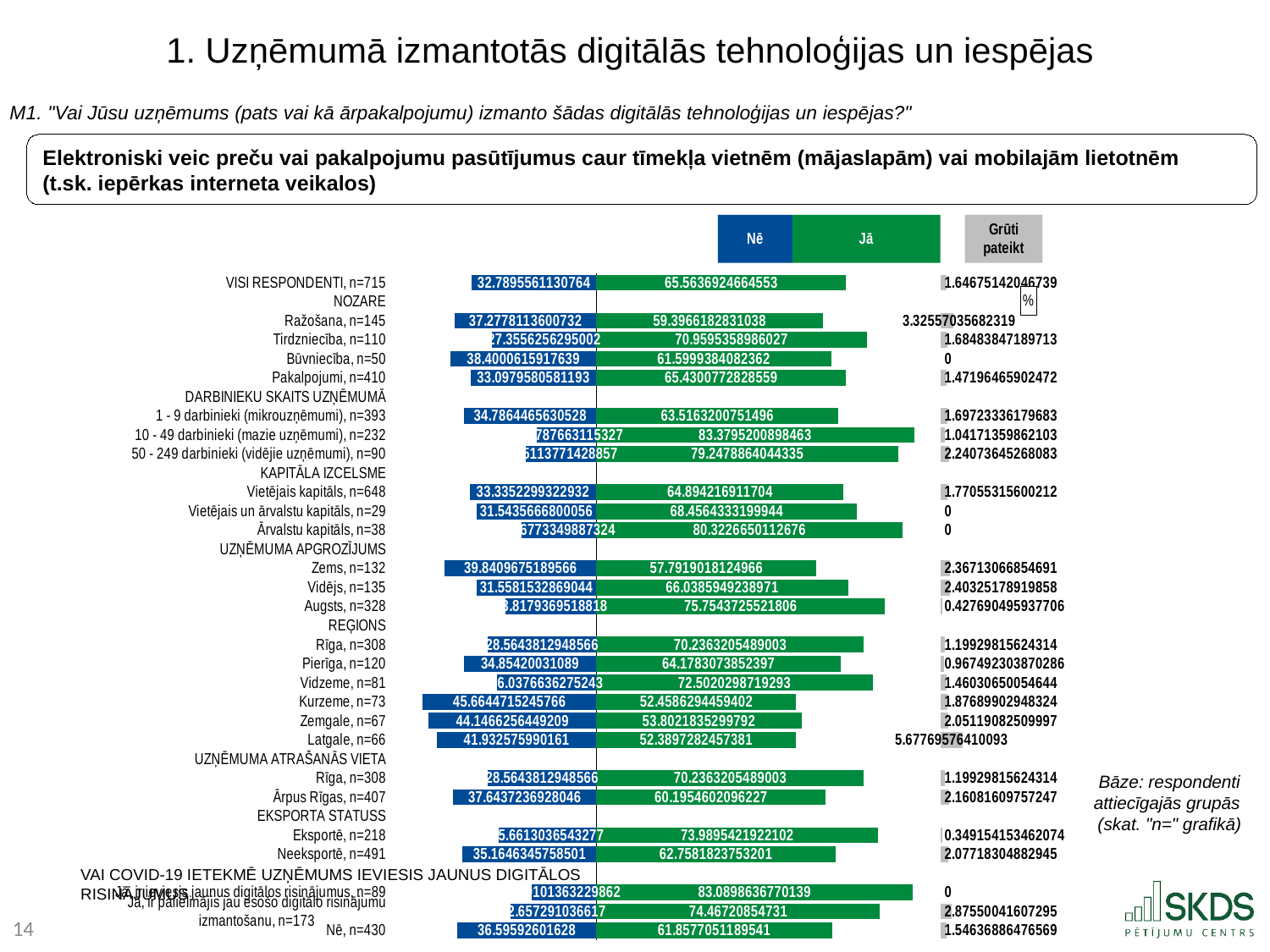
Which colour represents the "Jā" series in the legend? green What is the "Grūti pateikt" value for Latgale, n=66? 5.67769576410093 What kind of chart is shown on the slide? bar chart What is the "Jā" value for VISI RESPONDENTI, n=715? 65.5636924664553 What is the "Jā" value for Kurzeme, n=73? 52.4586294459402 Which is larger, the "Jā" value for Rīga, n=308 or for Ārpus Rīgas, n=407? Rīga, n=308 What is the difference between the "Jā" and "Nē" values for Vietējais un ārvalstu kapitāls, n=29? 36.9128666399888 Which is larger, the "Nē" value for Zems, n=132 or for Vidējs, n=135? Zems, n=132 Which category has the highest "Jā" value? 10 - 49 darbinieki (mazie uzņēmumi), n=232 What is the "Nē" value for Būvniecība, n=50? 38.4000615917639 Which category has the highest "Nē" value? Kurzeme, n=73 How many series does the legend list? 3